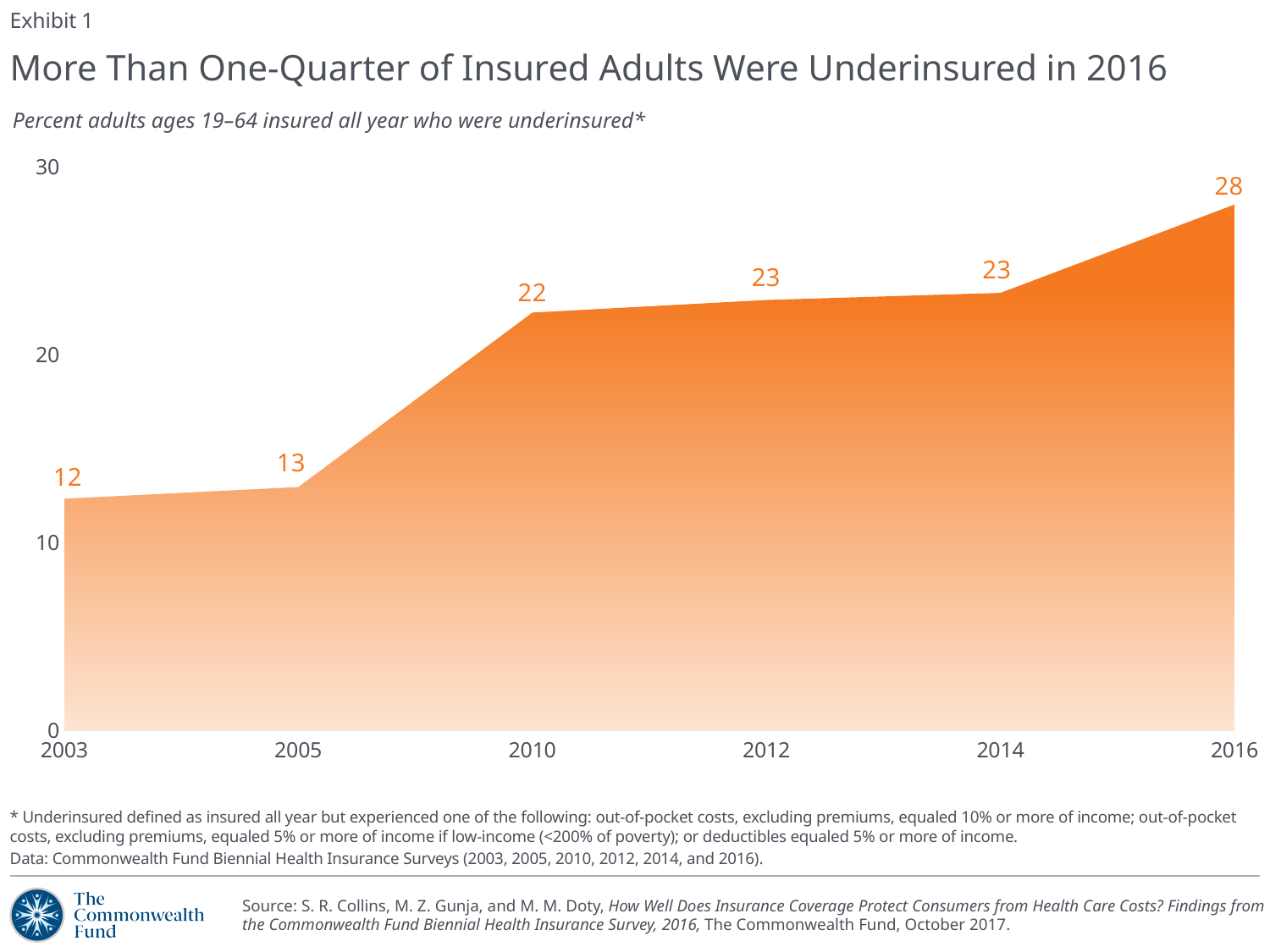
Is the value for 2012 greater or less than 20? greater What is the difference between the values for 2010 and 2005? 9 Do the values generally rise or fall from 2003 to 2016? Rise How many years are plotted on the chart? 6 What percent of insured adults were underinsured in 2003? 12 What is the value shown for 2010? 22 What is the value shown for 2016? 28 Which year has the lowest value? 2003 Which year has the highest value? 2016 What kind of chart is shown? Area chart What is the difference between the values for 2016 and 2003? 16 Which is larger, the value for 2005 or the value for 2014? 2014